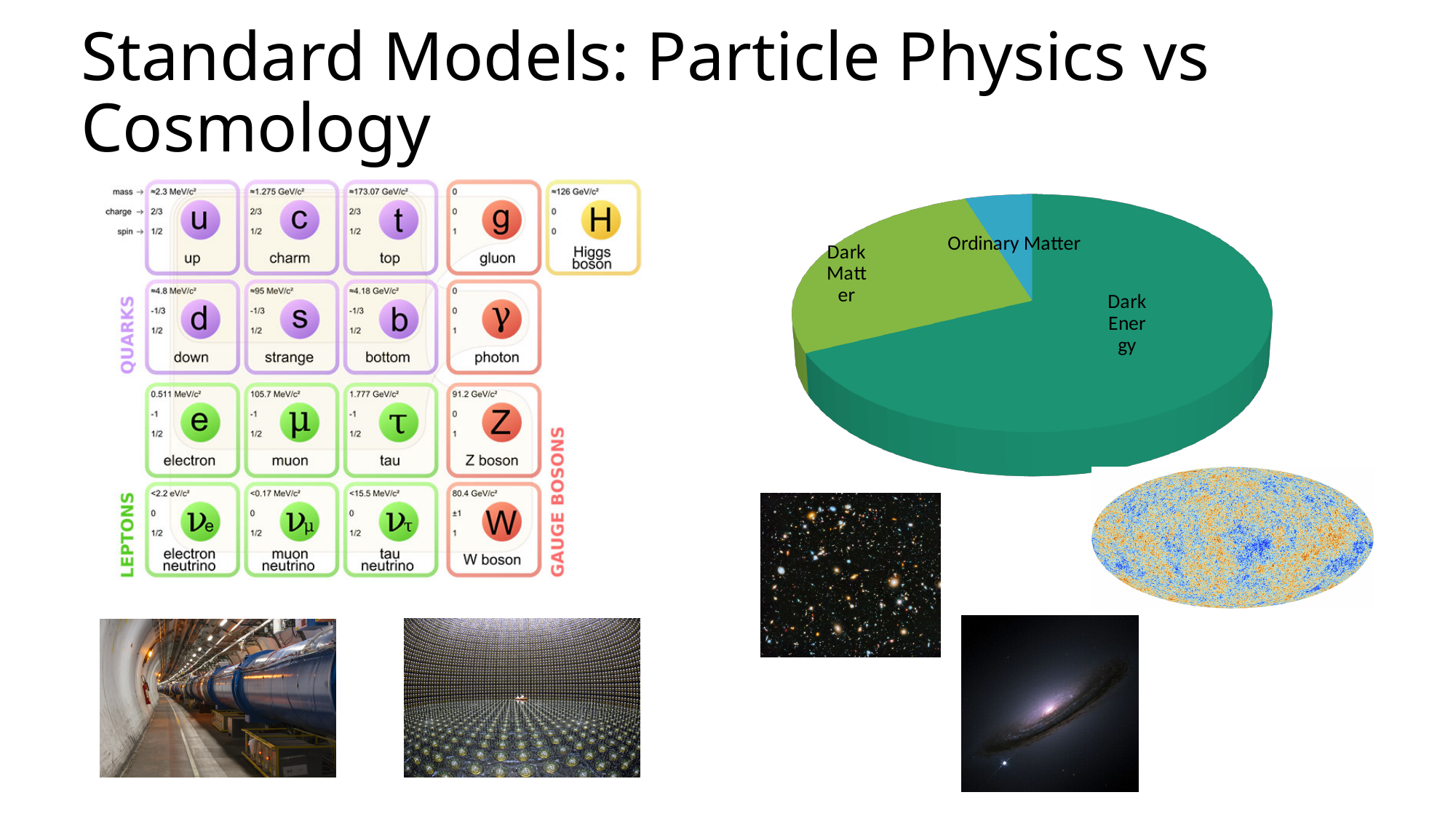
Which slice of the pie chart is the smallest? Ordinary Matter How many slices does the pie chart have? 3 Which slice of the pie chart is the largest? Dark Energy What colour is the Dark Energy slice in the pie chart? teal green In the pie chart, which is larger, Dark Energy or Dark Matter? Dark Energy What colour is the Ordinary Matter slice in the pie chart? blue What kind of chart is shown on the right side of the slide? pie chart In the pie chart, which is larger, Dark Matter or Ordinary Matter? Dark Matter